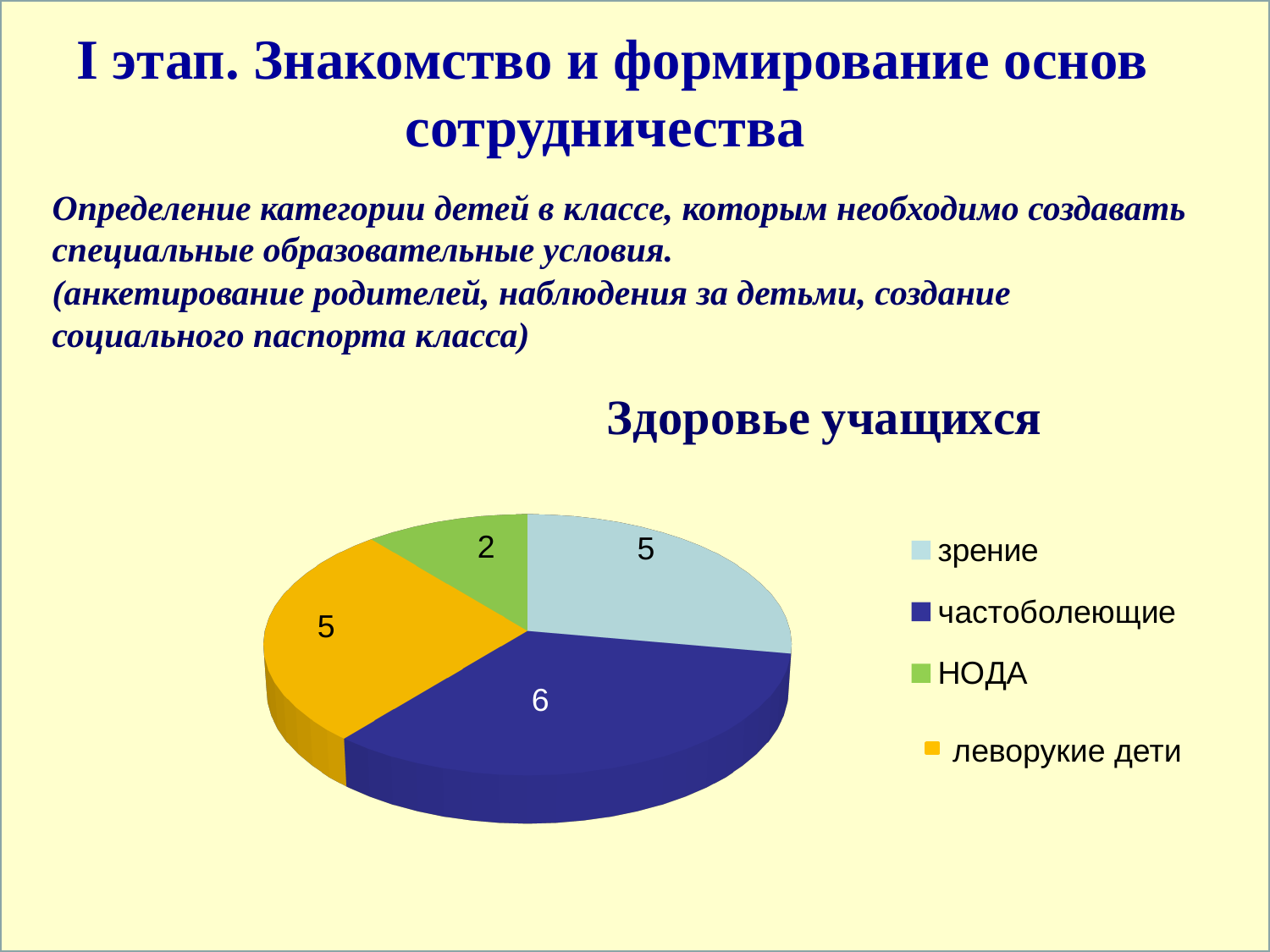
What is the value for НОДА in the pie chart? 2 Which category has the smallest slice in the pie chart? НОДА What is the value for зрение in the pie chart? 5 What is the total of all slices in the pie chart? 18 What is the title of the chart? Здоровье учащихся What is the value for леворукие дети in the pie chart? 5 How many categories are shown in the pie chart? 4 What is the value for частоболеющие in the pie chart? 6 What kind of chart is shown on the slide? pie chart Which category has the largest slice in the pie chart? частоболеющие What is the difference between the values for частоболеющие and НОДА? 4 Which is larger, the value for частоболеющие or the value for зрение? частоболеющие